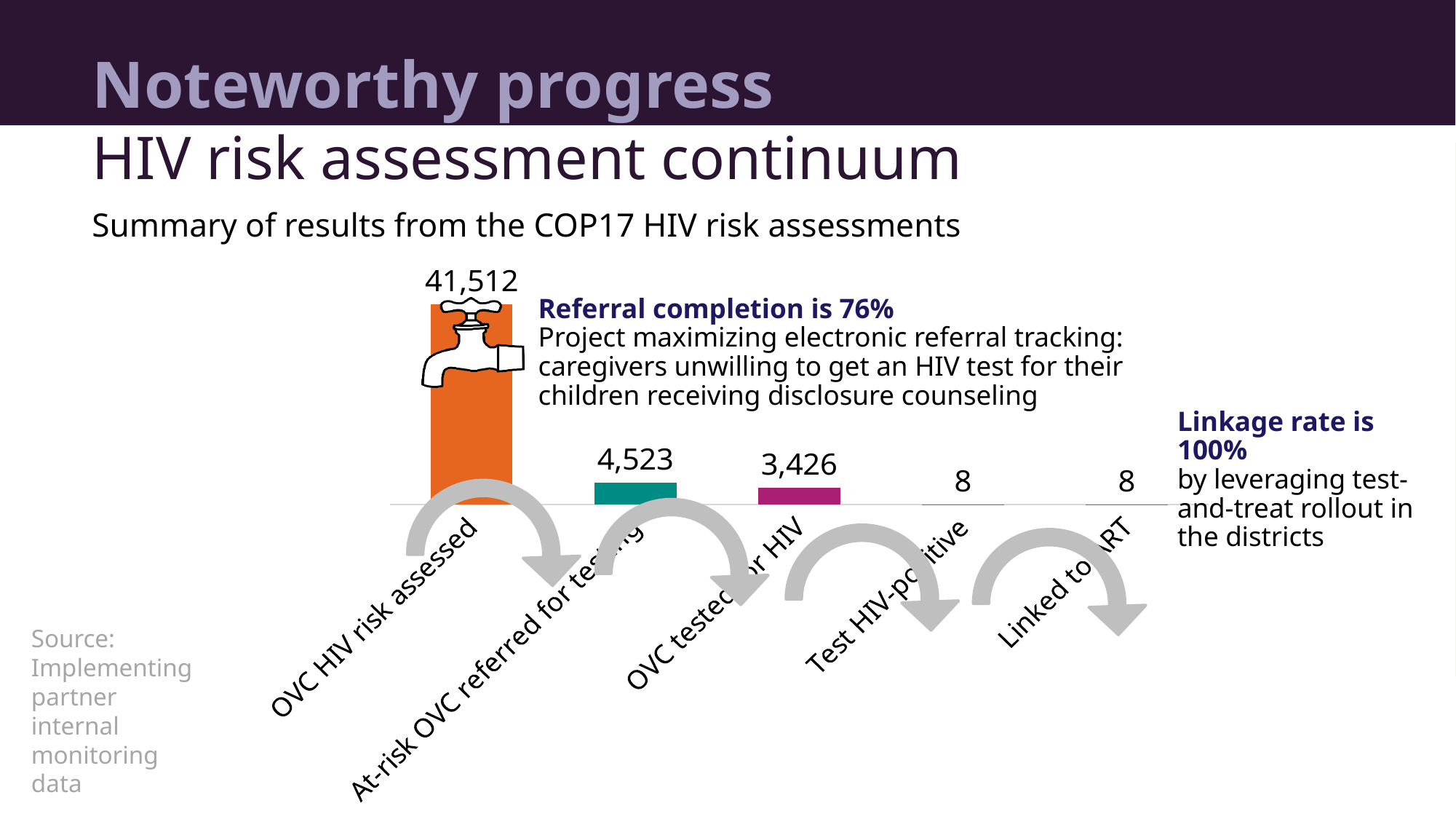
What is the value for Linked to ART? 8 Which is larger, the value for At-risk OVC referred for testing or the value for OVC tested for HIV? At-risk OVC referred for testing What kind of chart is shown on the slide? Bar chart What is the difference between the values for At-risk OVC referred for testing and OVC tested for HIV? 1,097 What is the value for At-risk OVC referred for testing? 4,523 How many categories are shown in the chart? 5 Do the values rise or fall from left to right along the x axis? Fall What is the value for Test HIV-positive? 8 What is the value for OVC HIV risk assessed? 41,512 Which category has the highest value? OVC HIV risk assessed What is the difference between the values for OVC HIV risk assessed and At-risk OVC referred for testing? 36,989 What is the value for OVC tested for HIV? 3,426